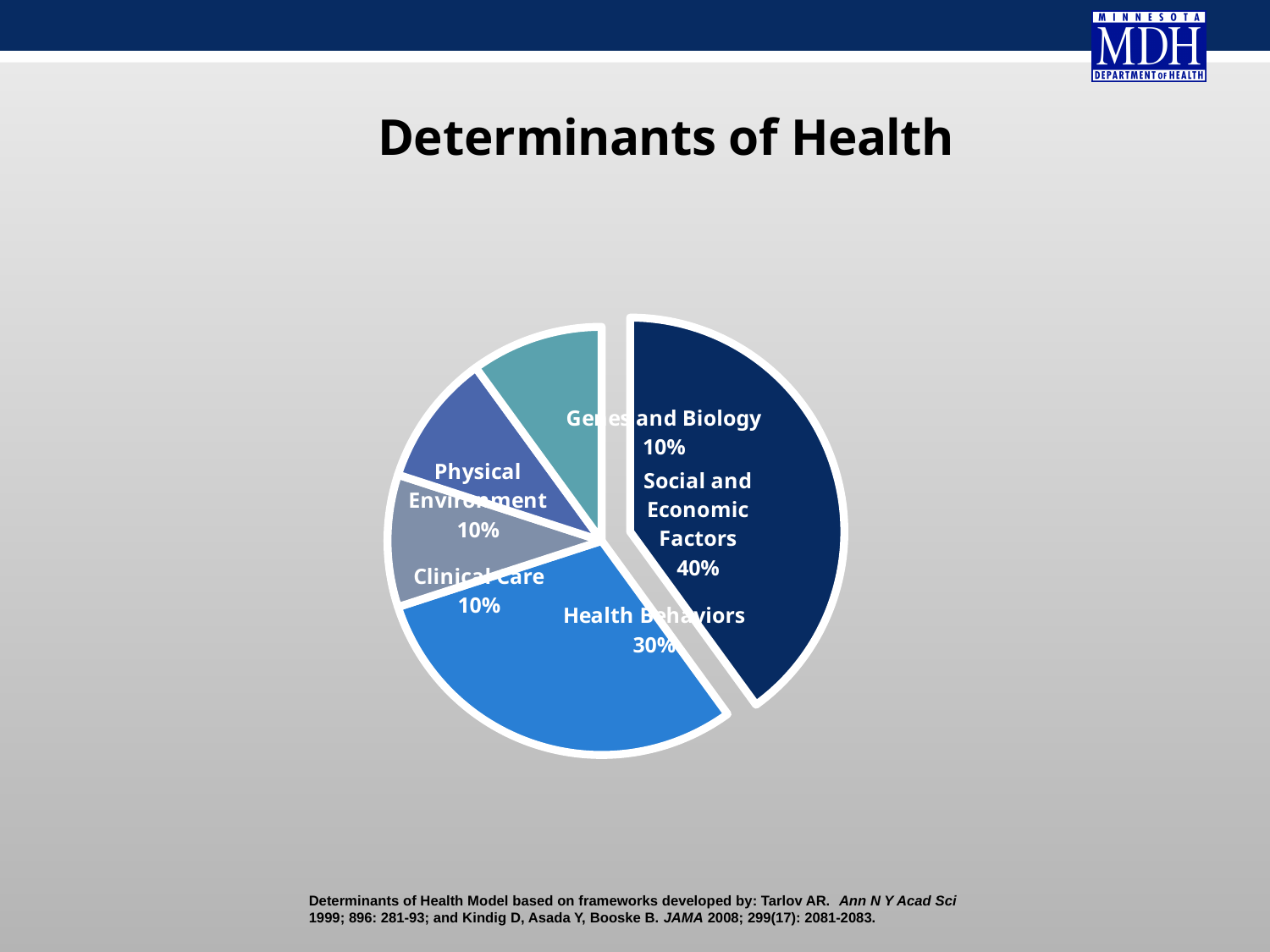
Which slice of the pie is the largest? Social and Economic Factors Which is larger, the Health Behaviors slice or the Clinical Care slice? Health Behaviors What share of the pie is Health Behaviors? 30% What share of the pie is Physical Environment? 10% What is the title of the slide containing the pie chart? Determinants of Health What share of the pie is Clinical Care? 10% How many slices does the pie chart have? 5 What kind of chart is shown on the slide? pie chart What is the difference between the Social and Economic Factors share and the Health Behaviors share? 10% What is the combined share of Social and Economic Factors and Health Behaviors? 70%